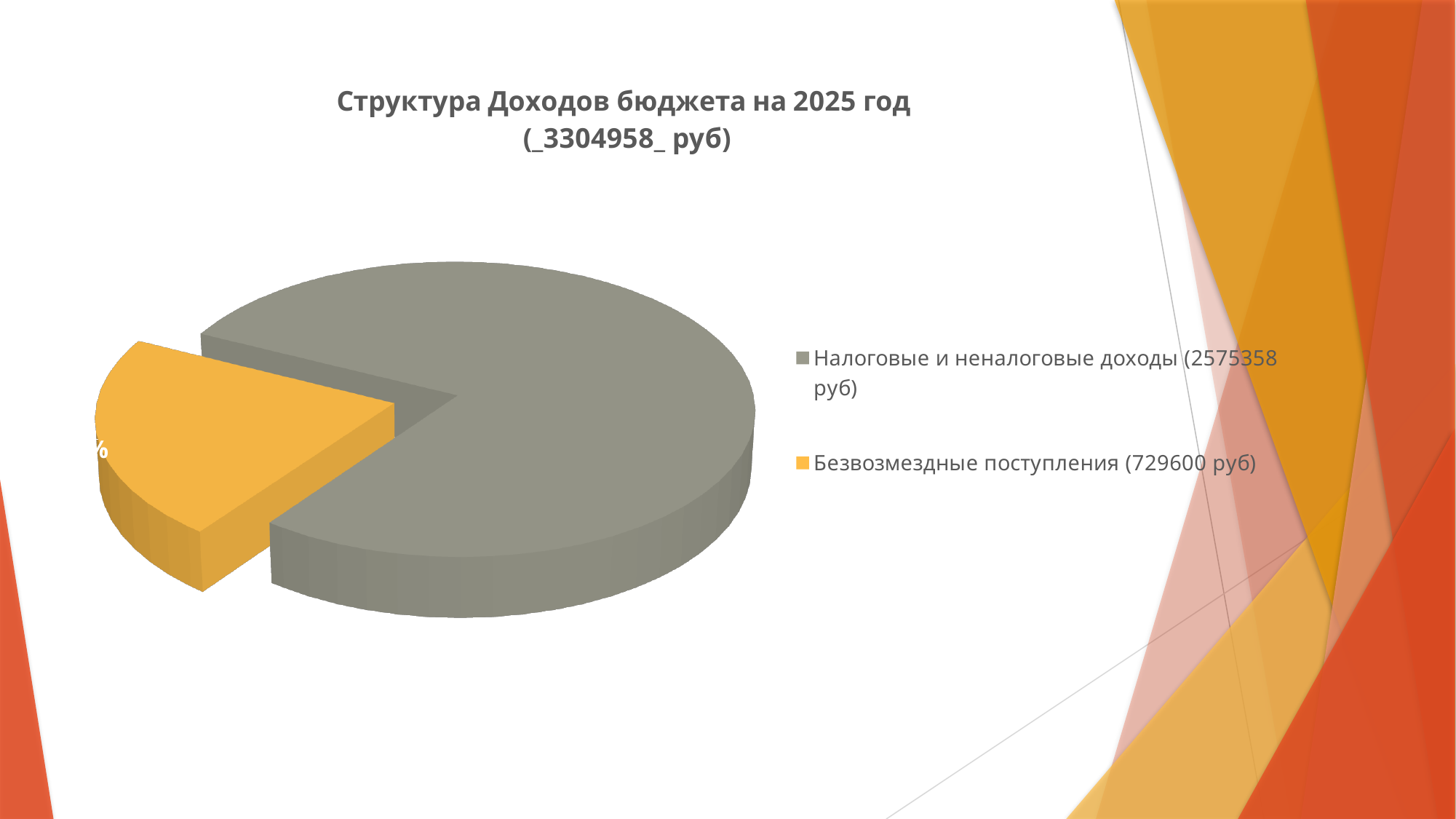
Which is larger: Налоговые и неналоговые доходы or Безвозмездные поступления? Налоговые и неналоговые доходы What is the title of the chart? Структура Доходов бюджета на 2025 год (_3304958_ руб) Which category has the largest slice in the pie chart? Налоговые и неналоговые доходы How many slices does the pie chart have? 2 What is the difference between Налоговые и неналоговые доходы and Безвозмездные поступления? 1845758 руб What total budget income is stated in the chart title? 3304958 руб What colour is the slice for Безвозмездные поступления? orange Which category has the smallest slice in the pie chart? Безвозмездные поступления How many entries does the legend of the pie chart list? 2 What kind of chart is shown on the slide? pie chart What value is given for Налоговые и неналоговые доходы in the legend? 2575358 руб What value is given for Безвозмездные поступления in the legend? 729600 руб